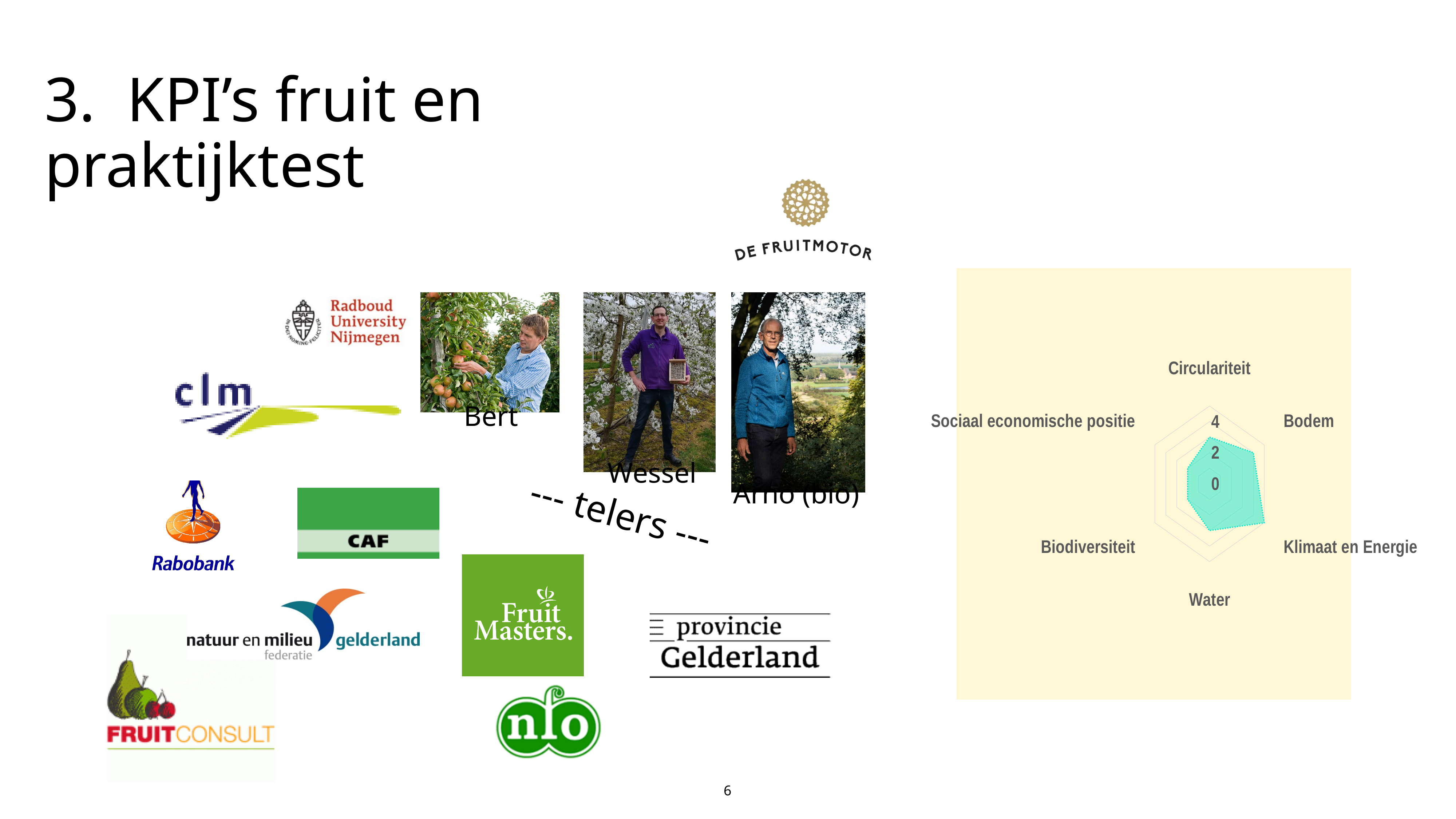
Which is larger on the radar chart: the value for Klimaat en Energie or the value for Sociaal economische positie? Klimaat en Energie Is the value for Circulariteit greater or less than 2? greater Is the value for Sociaal economische positie greater or less than 4? less Which category label appears at the top of the radar chart? Circulariteit What is the highest tick value shown on the radar chart's axis? 4 Is the value for Klimaat en Energie greater or less than 2? greater How many categories (axes) does the radar chart have? 6 What kind of chart is shown on the right side of the slide? radar chart Which is larger on the radar chart: the value for Bodem or the value for Sociaal economische positie? Bodem